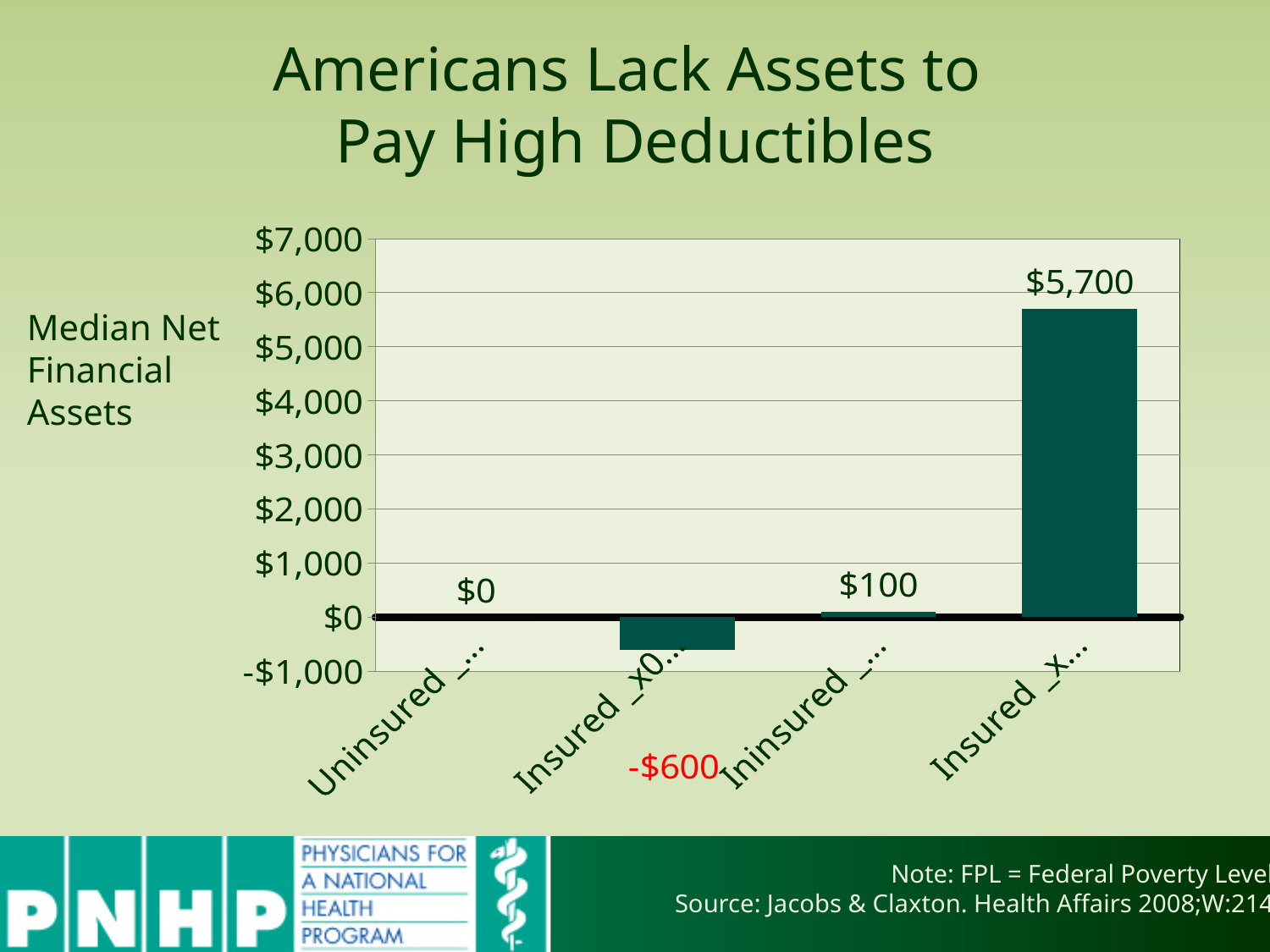
How many bars are plotted in the chart? 4 Which is larger, the value of the third bar or the value of the second bar? the third bar ($100) What is the value shown for the fourth (rightmost) bar? $5,700 What is the value shown for the first (leftmost) bar? $0 What quantity does the chart measure, according to the label to the left of the chart? Median Net Financial Assets What is the difference between the value of the fourth bar and the value of the third bar? $5,600 Which bar has the highest value? the fourth (rightmost) bar, $5,700 Which bar has the lowest value? the second bar, -$600 What type of chart is shown on the slide? bar chart What is the value shown for the third bar from the left? $100 What is the value shown for the second bar from the left? -$600 Is the value of the rightmost bar greater or less than $5,000? greater